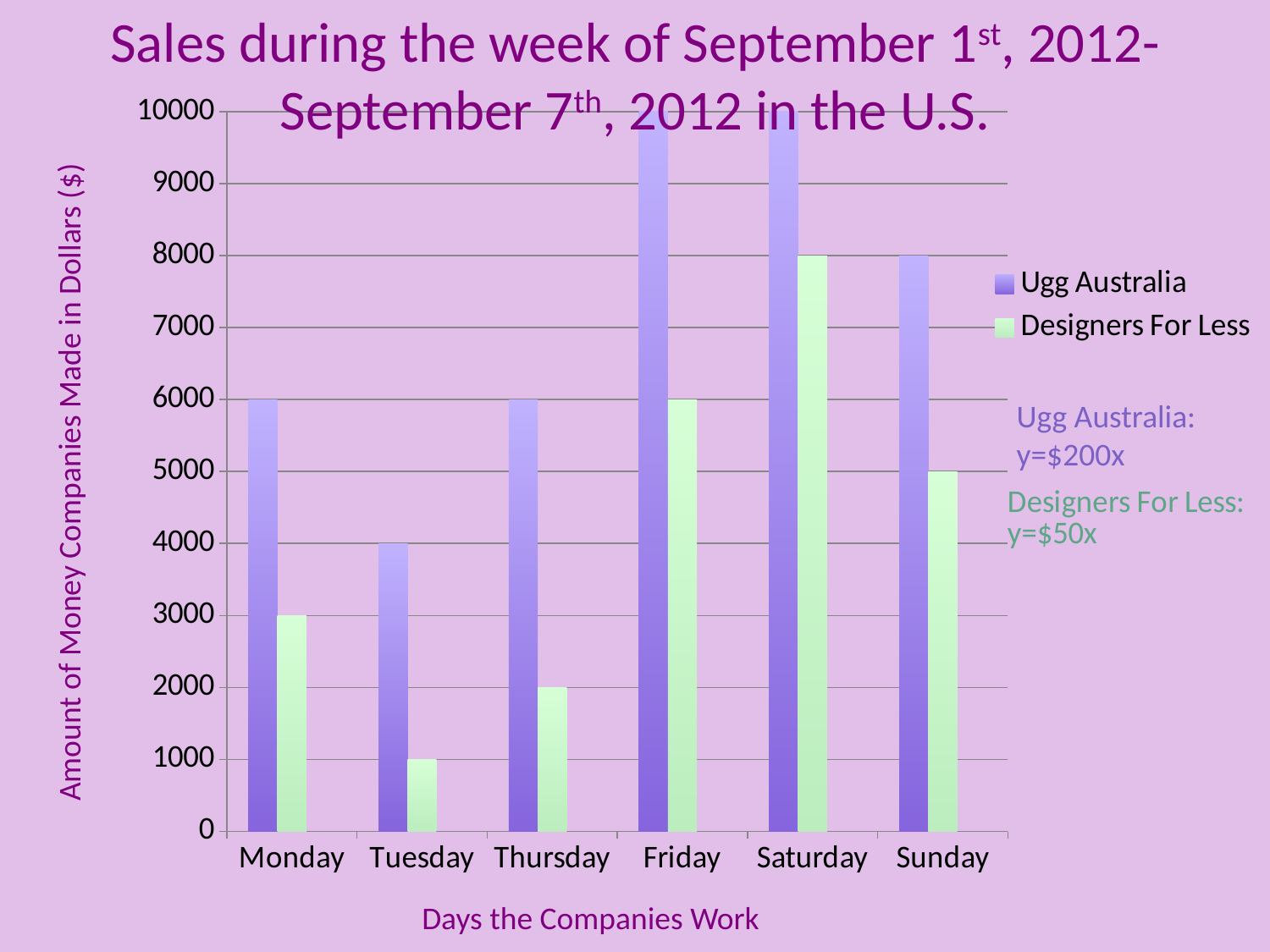
What is the label of the y axis? Amount of Money Companies Made in Dollars ($) What is the difference between Ugg Australia and Designers For Less on Sunday? 3000 Is the value for Ugg Australia on Sunday greater or less than 7000? greater Which is larger on Thursday, Ugg Australia or Designers For Less? Ugg Australia How many series does the legend list? 2 How many days are shown on the x axis? 6 What is the value for Designers For Less on Saturday? 8000 On which day is the Designers For Less value lowest? Tuesday What is the value for Ugg Australia on Tuesday? 4000 What kind of chart is shown on the slide? Bar chart On which day is the Designers For Less value highest? Saturday What is the value for Designers For Less on Monday? 3000